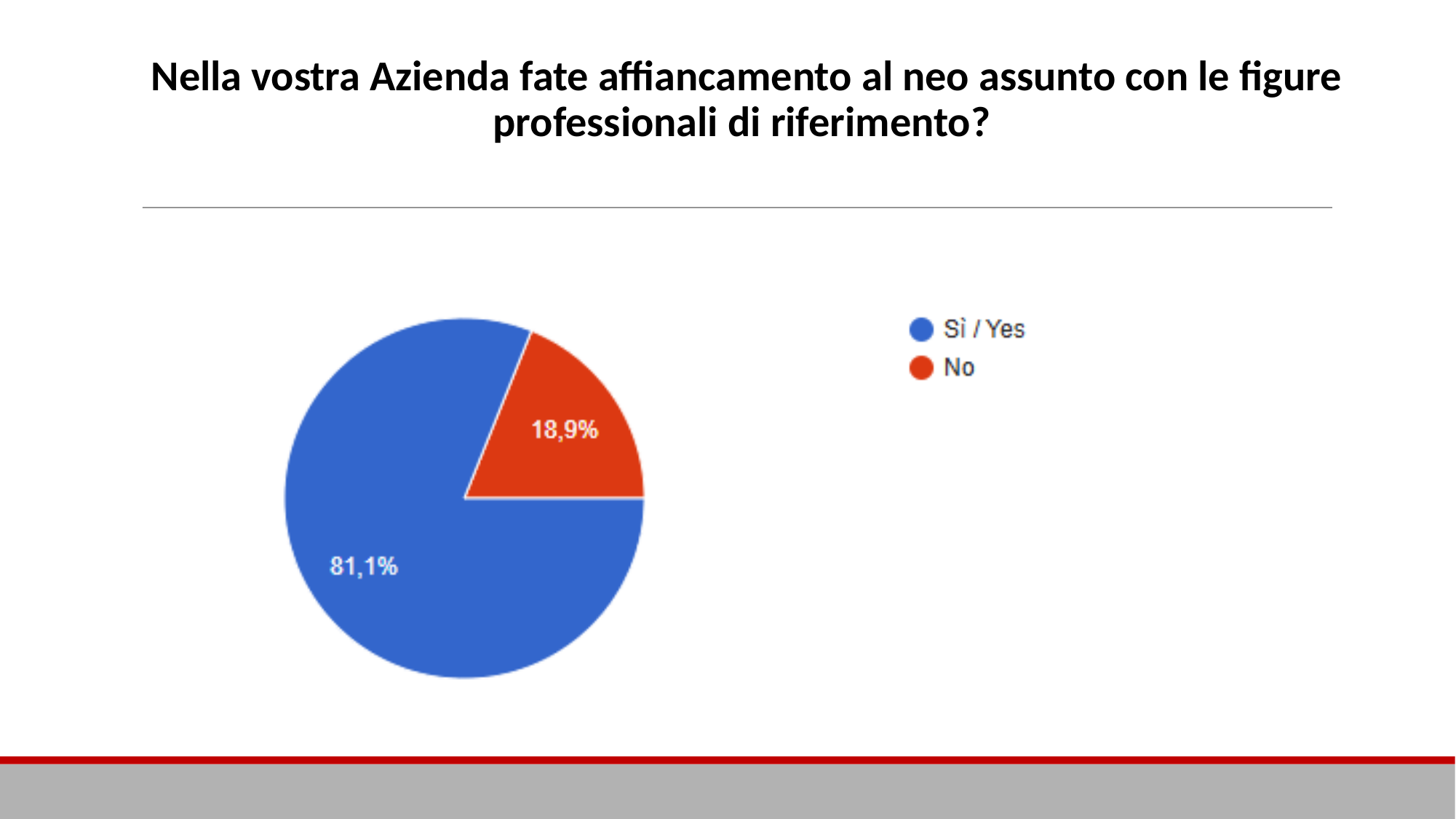
What is the difference in percentage points between the "Sì / Yes" slice and the "No" slice? 62,2 What share of the pie does the "Sì / Yes" slice represent? 81,1% How many entries does the legend list? 2 What colour is the "Sì / Yes" slice in the pie chart? blue Which slice is the smallest in the pie chart? No Which slice is the largest in the pie chart? Sì / Yes Which is larger, the "Sì / Yes" slice or the "No" slice? Sì / Yes What share of the pie does the "No" slice represent? 18,9% How many slices does the pie chart have? 2 What colour is the "No" slice in the pie chart? red What kind of chart is shown on the slide? pie chart